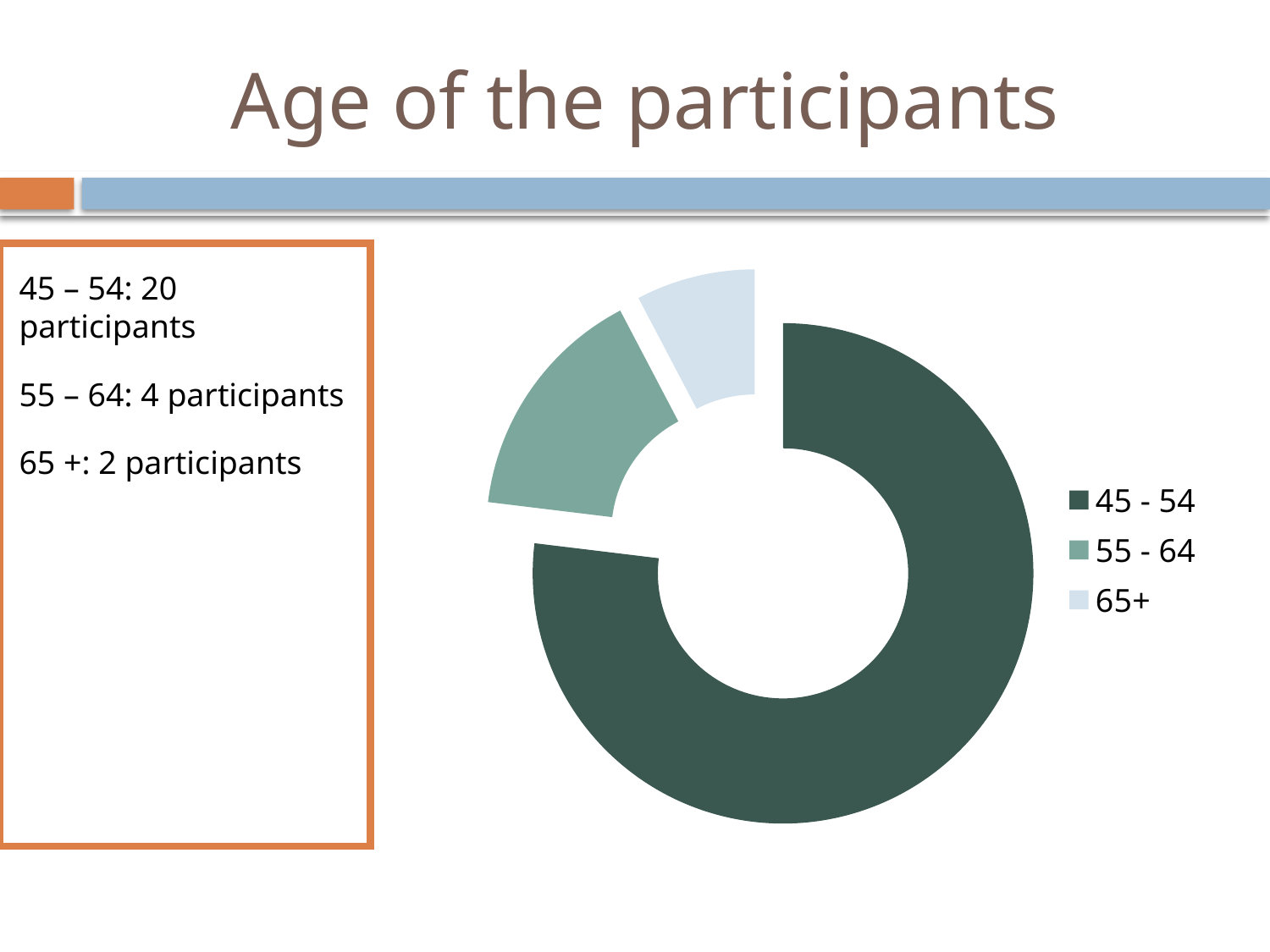
According to the slide, how many participants are aged 65+? 2 participants How many entries does the chart's legend list? 3 How many more participants are in the 45 – 54 group than in the 55 – 64 group? 16 What kind of chart is shown on the slide? Doughnut chart Which age group has the largest slice in the chart? 45 - 54 Which slice is larger, 55 - 64 or 65+? 55 - 64 What is the total number of participants across all three age groups shown? 26 According to the slide, how many participants are in the 55 – 64 age group? 4 participants According to the slide, how many participants are in the 45 – 54 age group? 20 participants How many age categories does the chart show? 3 Which age group has the smallest slice in the chart? 65+ What is the title of the slide containing the chart? Age of the participants